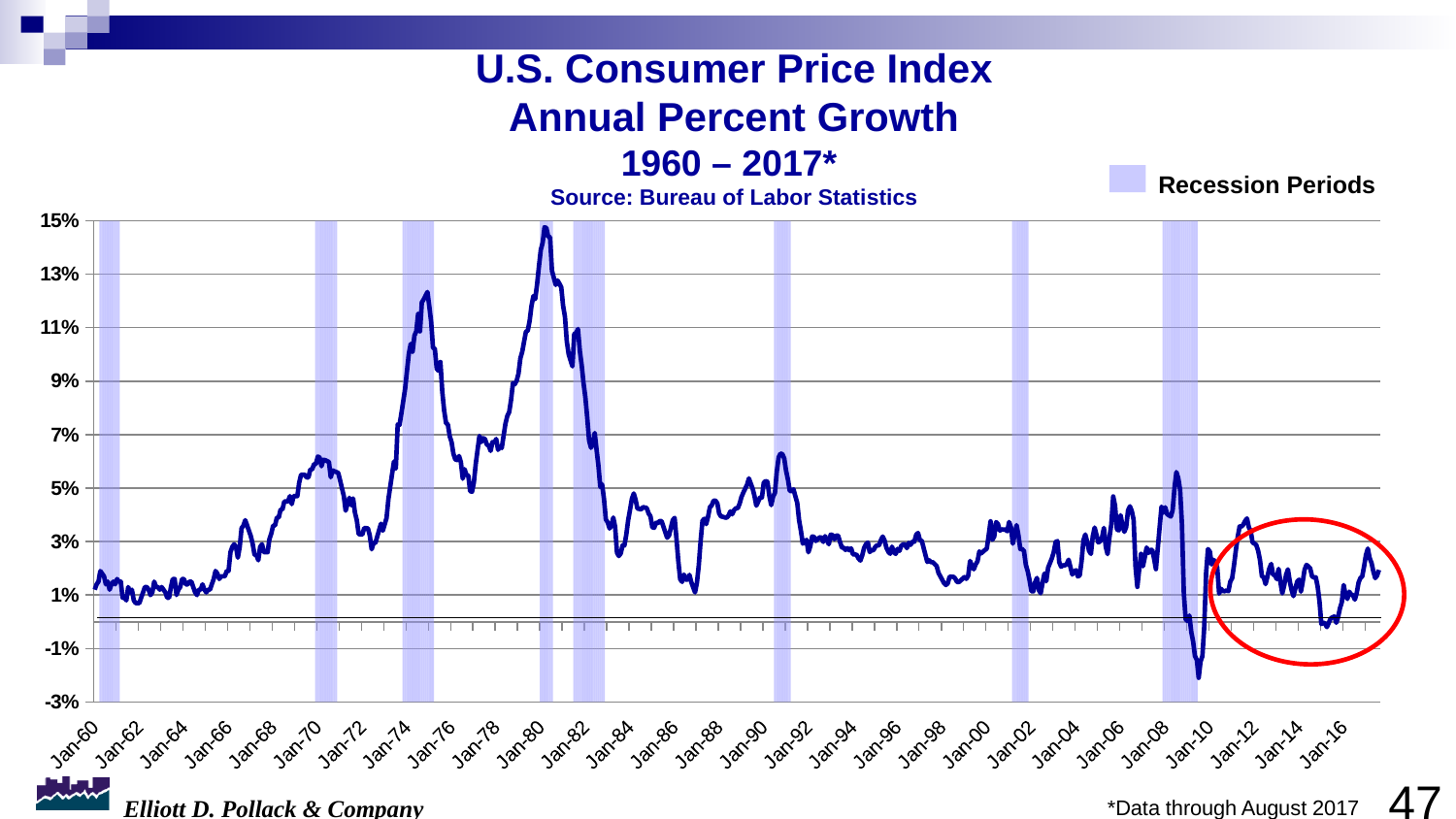
What do the shaded vertical bands on the chart represent, according to the legend? Recession Periods Is the peak value of the line around Jan-74 greater or less than 11%? greater Around which x-axis label does the line reach its highest point? Jan-80 Is the value at Jan-70 greater or less than 5%? greater Is the peak value of the line around Jan-80 greater or less than 13%? greater What is the title of the chart? U.S. Consumer Price Index Annual Percent Growth 1960 – 2017* Does the line rise or fall between Jan-80 and Jan-84? fall What kind of chart is shown on the slide? line chart How many shaded recession periods are marked on the chart? 8